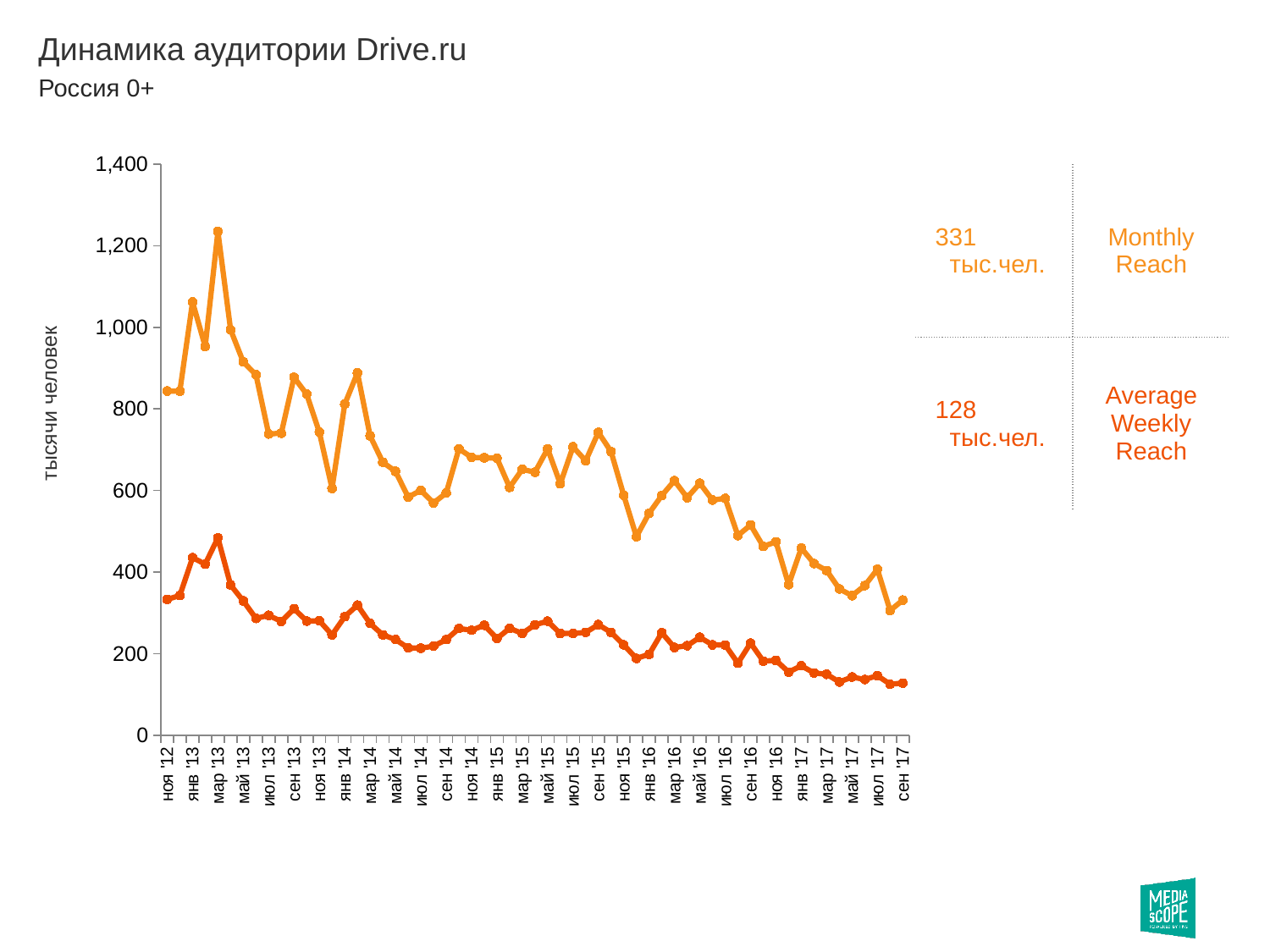
In which month does the Monthly Reach line reach its highest point? мар '13 What kind of chart is shown on the slide? line chart Which series is higher at сен '17, Monthly Reach or Average Weekly Reach? Monthly Reach Is the Monthly Reach value at мар '13 greater or less than 1,000? greater What is the difference between the printed Monthly Reach and Average Weekly Reach values? 203 тыс.чел. What is the label on the vertical axis of the chart? тысячи человек What is the Average Weekly Reach value printed on the slide? 128 тыс.чел. Is the Average Weekly Reach value at сен '17 greater or less than 200? less What is the Monthly Reach value printed on the slide? 331 тыс.чел. Is the Average Weekly Reach value at мар '13 greater or less than 400? greater How many series are plotted on the chart? 2 Does the Monthly Reach line rise or fall overall from ноя '12 to сен '17? fall